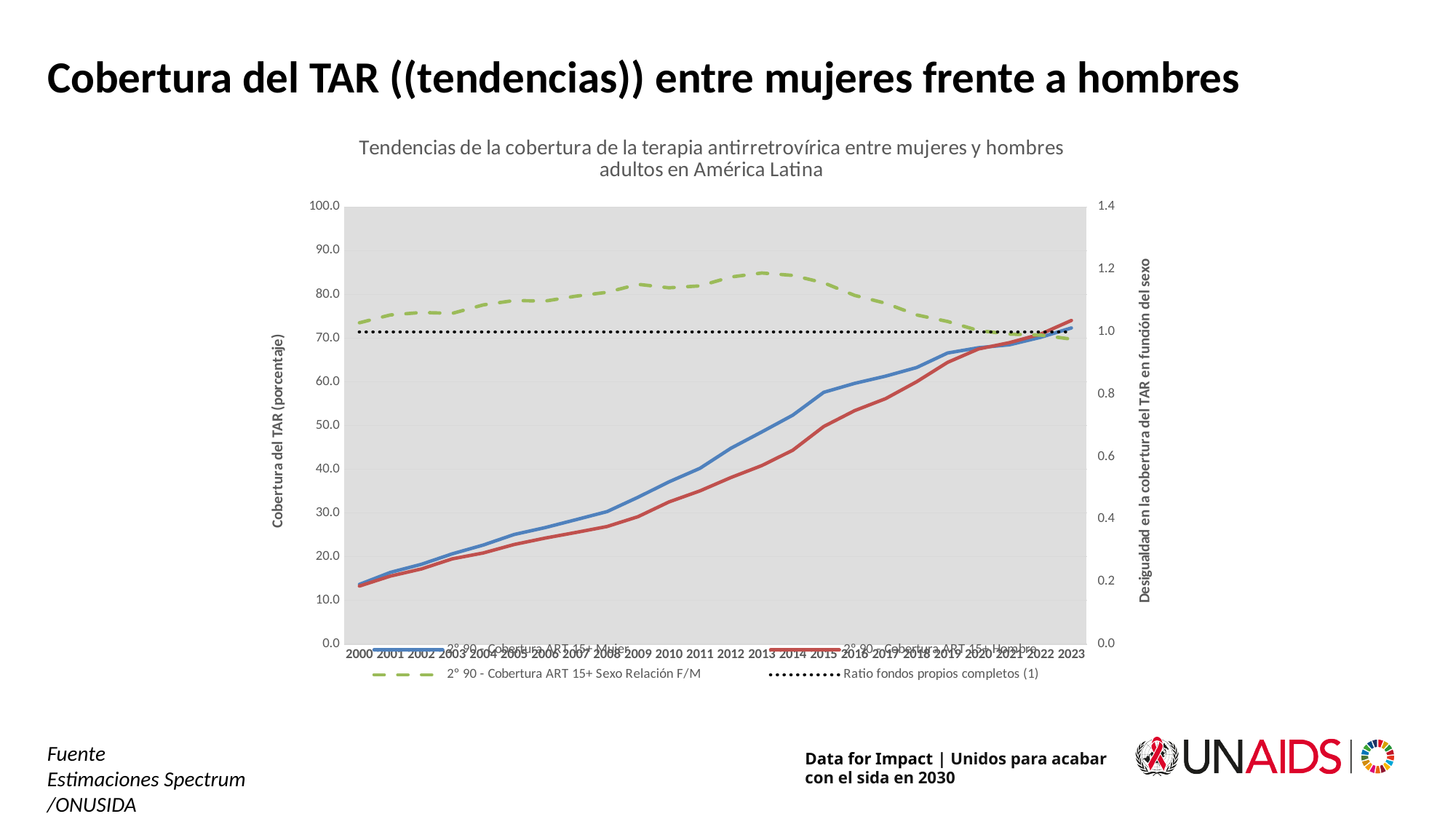
Does the '2° 90 - Cobertura ART 15+ Mujer' line rise or fall from 2000 to 2023? rise On the right-hand axis, is the value for '2° 90 - Cobertura ART 15+ Sexo Relación F/M' in 2013 greater or less than 1.0? greater What kind of chart is shown on the slide? line chart Is the value for '2° 90 - Cobertura ART 15+ Mujer' in 2015 greater or less than 50.0? greater How many series does the chart's legend list? 4 Is the value for '2° 90 - Cobertura ART 15+ Hombre' in 2010 greater or less than 40.0? less What is the label of the left vertical axis of the chart? Cobertura del TAR (porcentaje) Does the '2° 90 - Cobertura ART 15+ Hombre' line rise or fall from 2000 to 2023? rise What is the title of the chart? Tendencias de la cobertura de la terapia antirretrovírica entre mujeres y hombres adultos en América Latina In 2015, which series has the higher value: '2° 90 - Cobertura ART 15+ Mujer' or '2° 90 - Cobertura ART 15+ Hombre'? 2° 90 - Cobertura ART 15+ Mujer How many years are shown along the x axis of the chart? 24